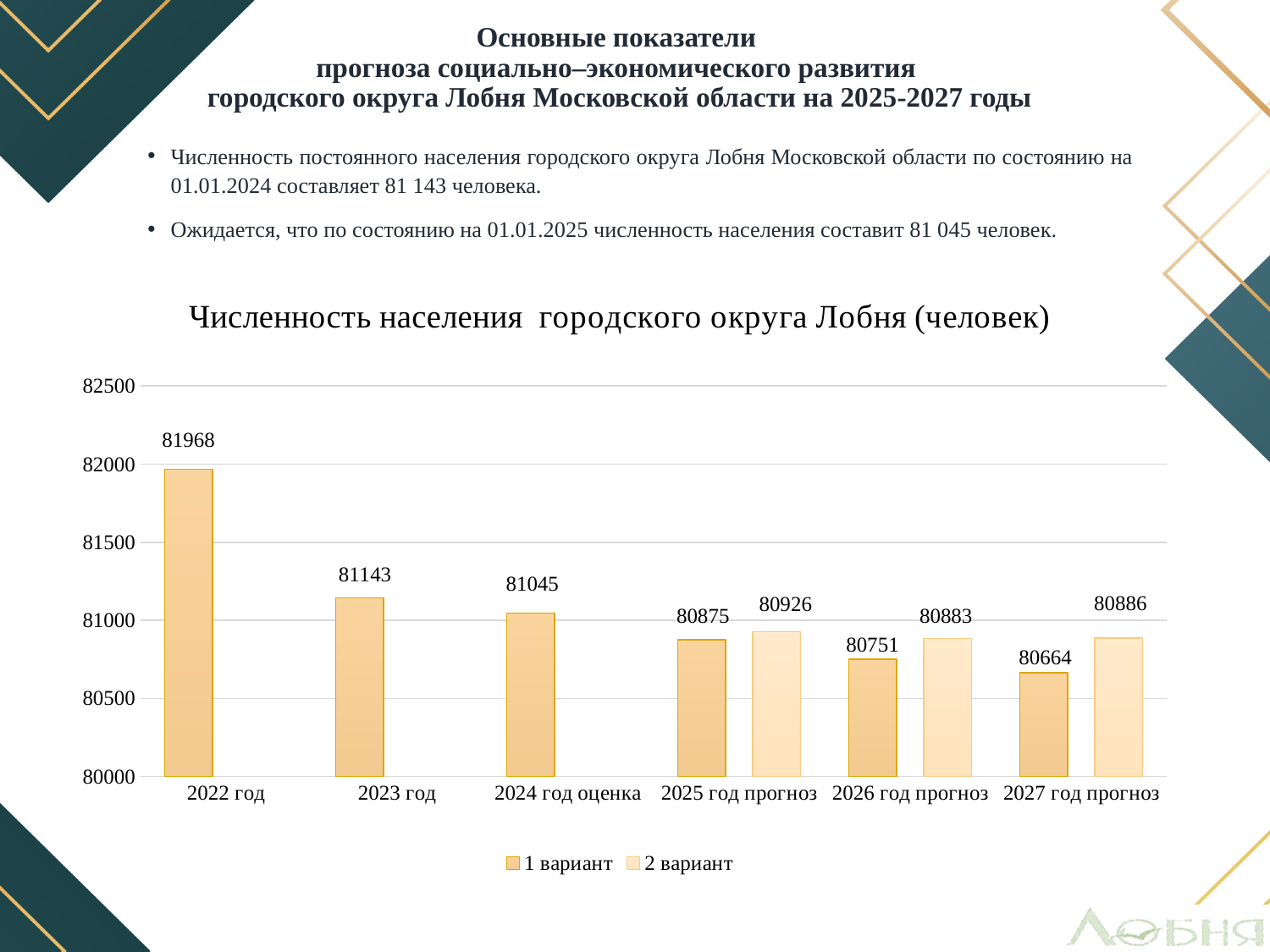
Do the 1 вариант values rise or fall from 2022 год to 2027 год прогноз? fall Which is larger for 2027 год прогноз: 1 вариант or 2 вариант? 2 вариант What is the value for 2022 год in the chart? 81968 Which category has the highest value in the chart? 2022 год What is the difference between 2 вариант and 1 вариант for 2025 год прогноз? 51 What is the value of 2 вариант for 2026 год прогноз? 80883 What kind of chart is shown on the slide? bar chart Which category has the lowest value for 1 вариант? 2027 год прогноз How many categories are shown on the x axis? 6 How many series does the legend list? 2 What is the difference between the 2022 год value and the 2023 год value? 825 What is the value of 1 вариант for 2027 год прогноз? 80664